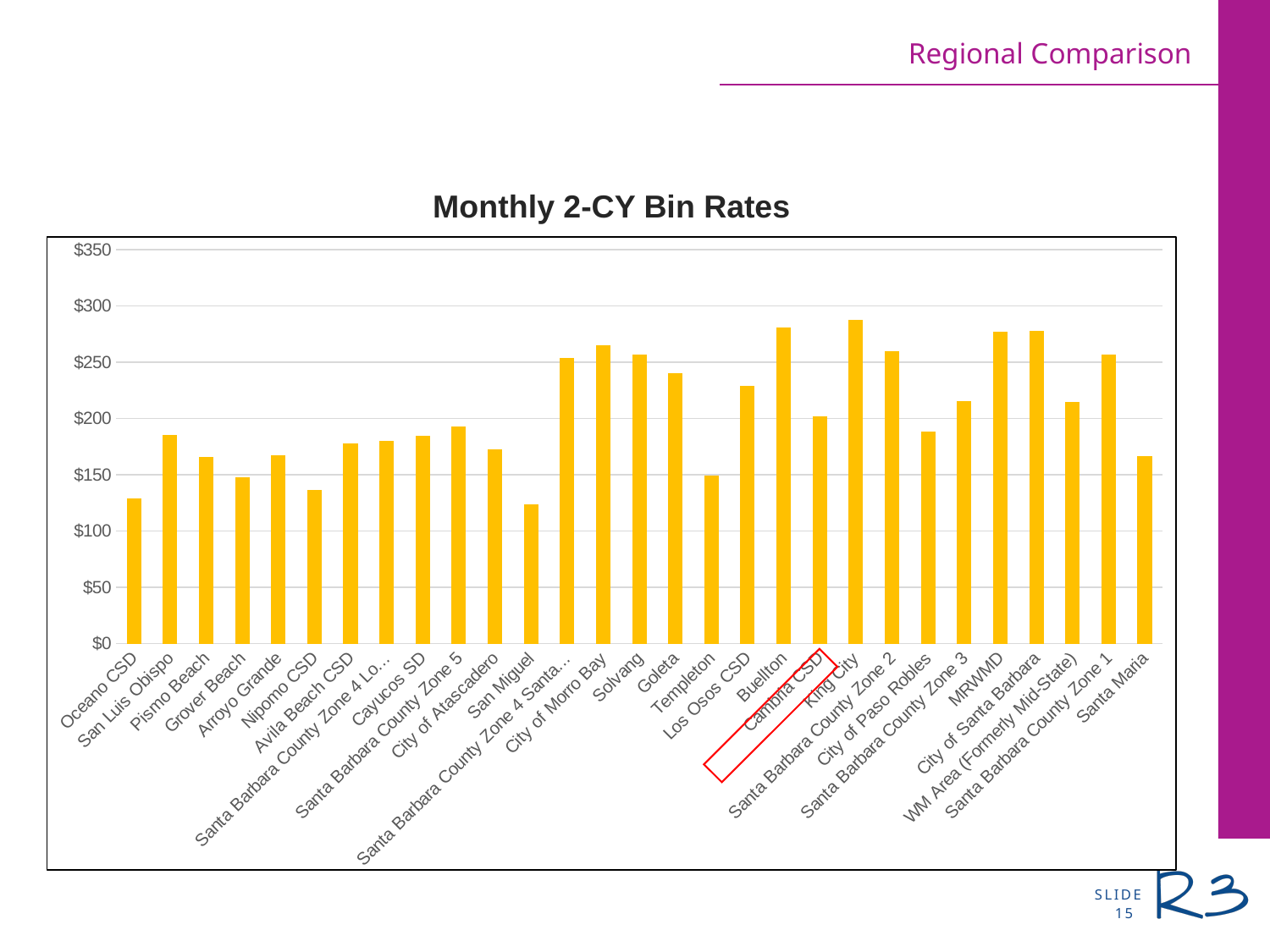
Is the value for Goleta greater or less than $200? greater What kind of chart is shown on the slide? Bar chart Which has a higher monthly 2-CY bin rate, City of Morro Bay or Templeton? City of Morro Bay Is the value for Santa Maria greater or less than $200? less Which has a higher monthly 2-CY bin rate, Buellton or City of Paso Robles? Buellton Is the value for Oceano CSD greater or less than $150? less How many categories (bars) are plotted in the chart? 29 Which category label is outlined in red on the x axis? Cambria CSD What is the title of the chart? Monthly 2-CY Bin Rates Which category has the highest monthly 2-CY bin rate? King City